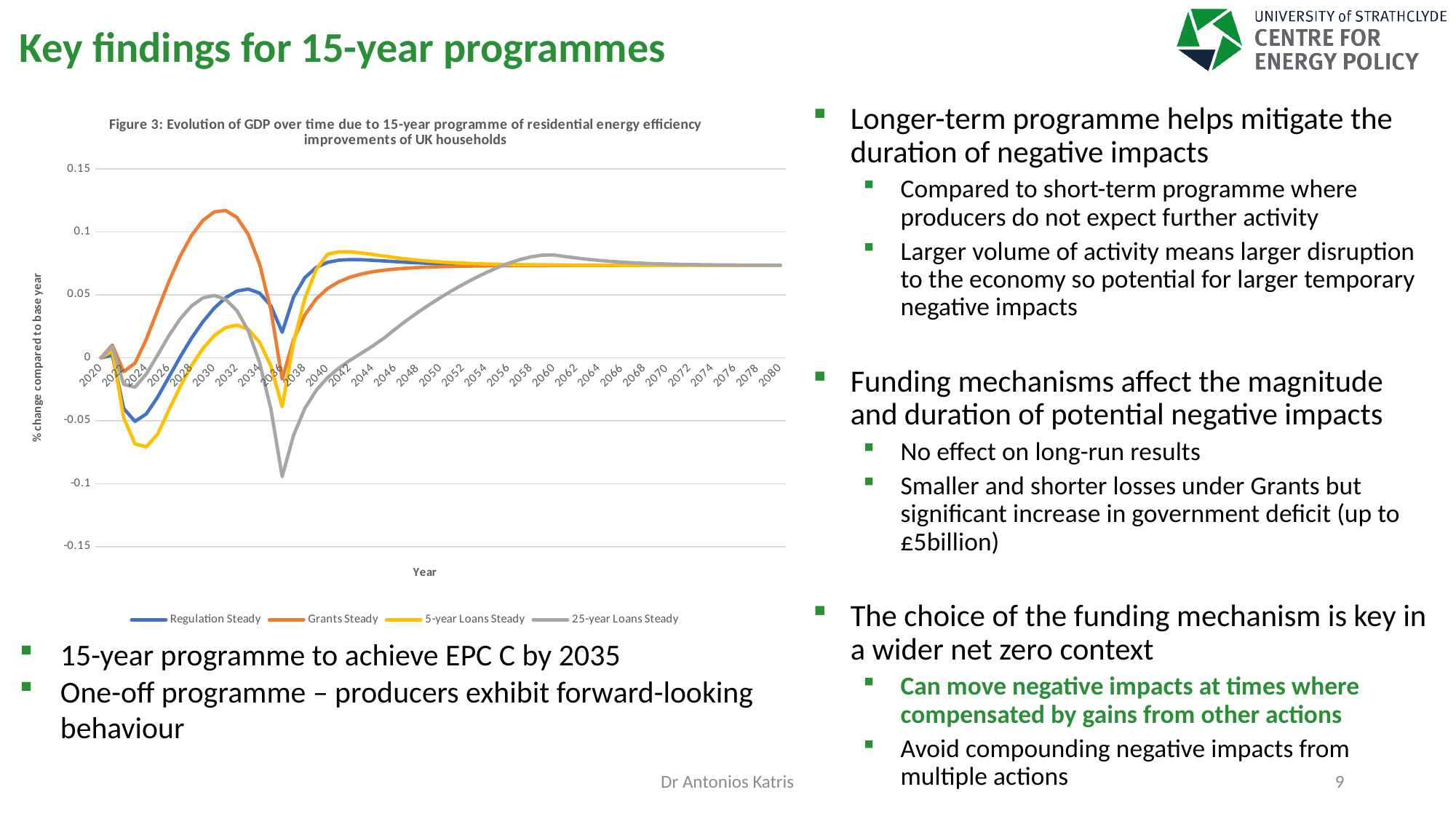
Between 2024 and 2030, does the Grants Steady series rise or fall? rise Which series reaches the lowest value on the chart? 25-year Loans Steady Around 2036, which series has the higher value: Grants Steady or 25-year Loans Steady? Grants Steady Is the lowest value of the 5-year Loans Steady series, around 2024, greater or less than -0.05? less Which series reaches the highest value on the chart? Grants Steady What kind of chart is shown on the slide? Line chart Is the peak value of the Grants Steady series greater or less than 0.1? greater How many series does the chart's legend list? 4 Around 2030, which series has the higher value: Grants Steady or 5-year Loans Steady? Grants Steady What is the title of the chart? Figure 3: Evolution of GDP over time due to 15-year programme of residential energy efficiency improvements of UK households Is the lowest value of the 25-year Loans Steady series greater or less than -0.05? less What is the label on the chart's vertical axis? % change compared to base year